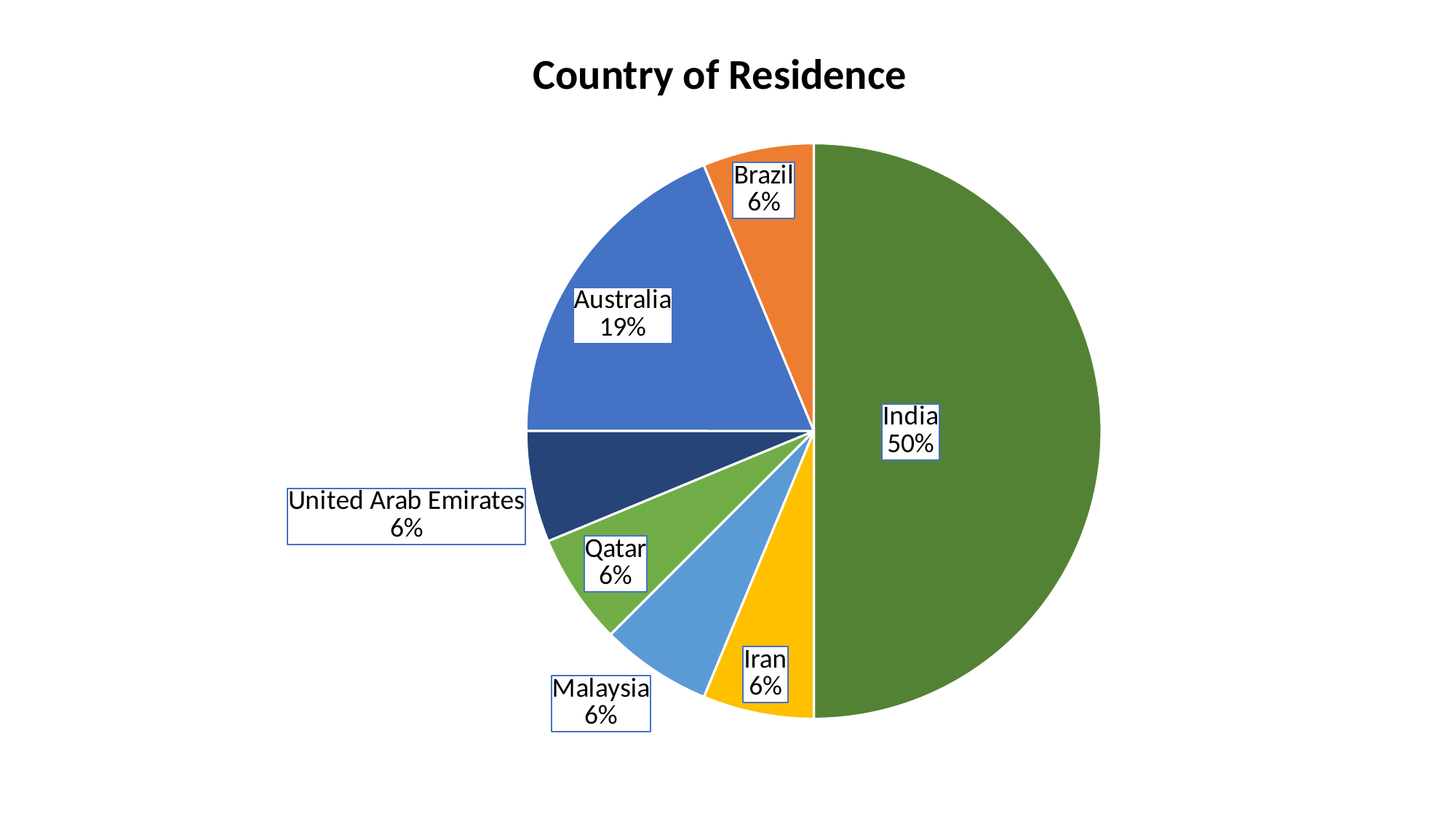
What kind of chart is shown on the slide? pie chart How many slices does the pie chart have? 7 What is the title of the chart? Country of Residence What is the difference between the shares of India and Australia? 31% What is the difference between the shares of Australia and Malaysia? 13% What share of the pie does United Arab Emirates have? 6% What share of the pie does India have? 50% What share of the pie does Brazil have? 6% Which country has the largest slice of the pie? India Which is larger, the share for Australia or the share for Iran? Australia What colour is the slice for India? green